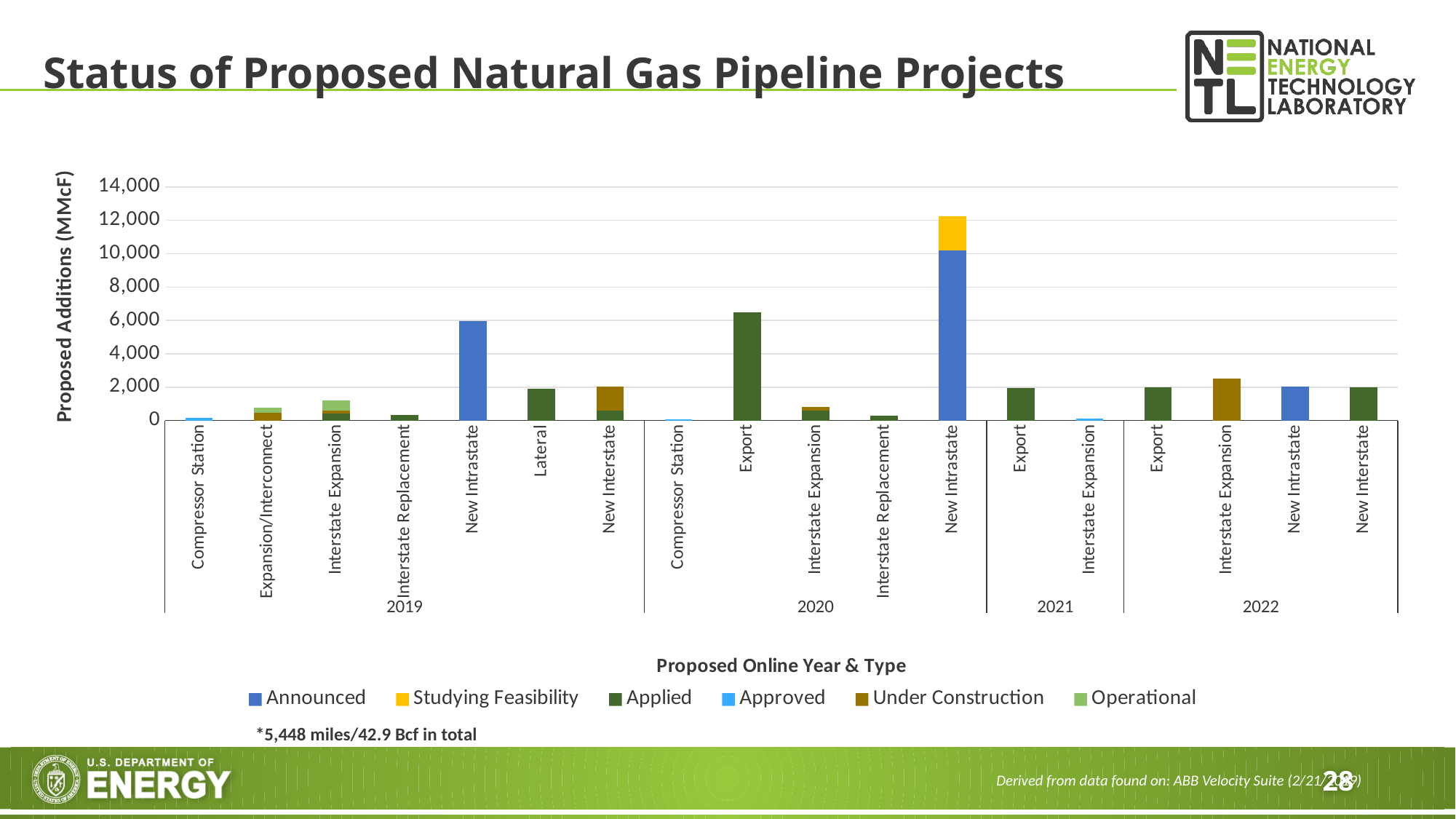
How many bars (year-and-type categories) are plotted along the x axis? 18 Is the value for New Intrastate in 2019 greater or less than 4,000? greater Which series is shown in yellow in the legend? Studying Feasibility Which is larger: the bar for New Intrastate in 2020 or the bar for New Intrastate in 2019? New Intrastate in 2020 What kind of chart is shown on the slide? Stacked bar chart Is the total value for New Intrastate in 2020 greater or less than 10,000? greater Is the value for Interstate Expansion in 2019 greater or less than 2,000? less What is the label of the y axis? Proposed Additions (MMcF) How many series does the legend list? 6 Which is larger: the bar for Interstate Expansion in 2022 or the bar for Export in 2022? Interstate Expansion in 2022 Which category has the tallest bar? New Intrastate (2020)